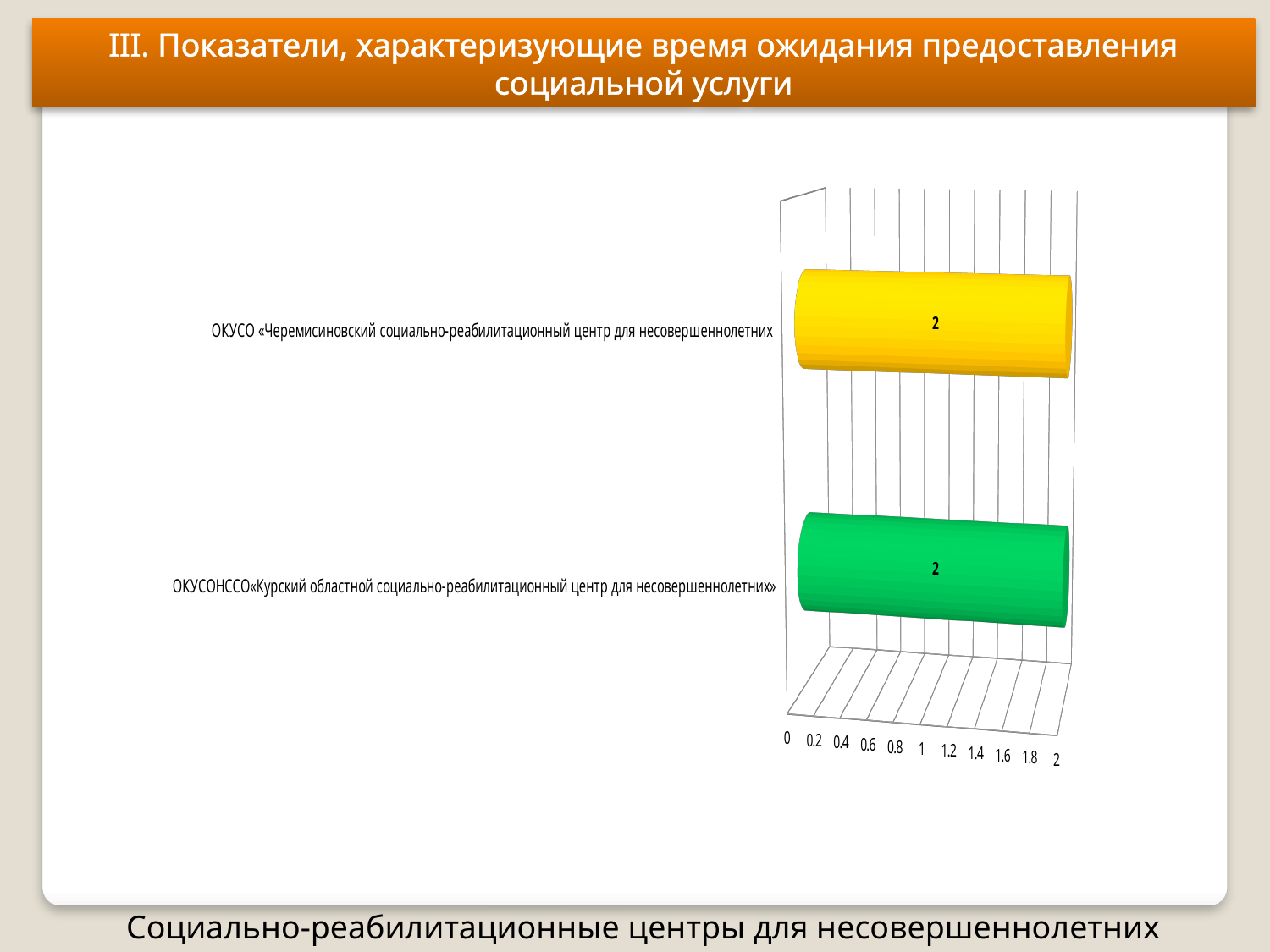
Is the value for ОКУСОНССО «Курский областной социально-реабилитационный центр для несовершеннолетних» greater or less than 1.8? greater How many categories (bars) does the chart show? 2 What is the maximum value shown on the horizontal axis? 2 What is the difference between the values for the Черемисиновский centre and the Курский областной centre? 0 What kind of chart is shown on the slide? bar chart Is the value for ОКУСО «Черемисиновский социально-реабилитационный центр для несовершеннолетних» greater or less than 1? greater What is the value for ОКУСО «Черемисиновский социально-реабилитационный центр для несовершеннолетних»? 2 What colour is the bar for ОКУСО «Черемисиновский социально-реабилитационный центр для несовершеннолетних»? yellow What is the value for ОКУСОНССО «Курский областной социально-реабилитационный центр для несовершеннолетних»? 2 Do the two bars in the chart have the same value? yes